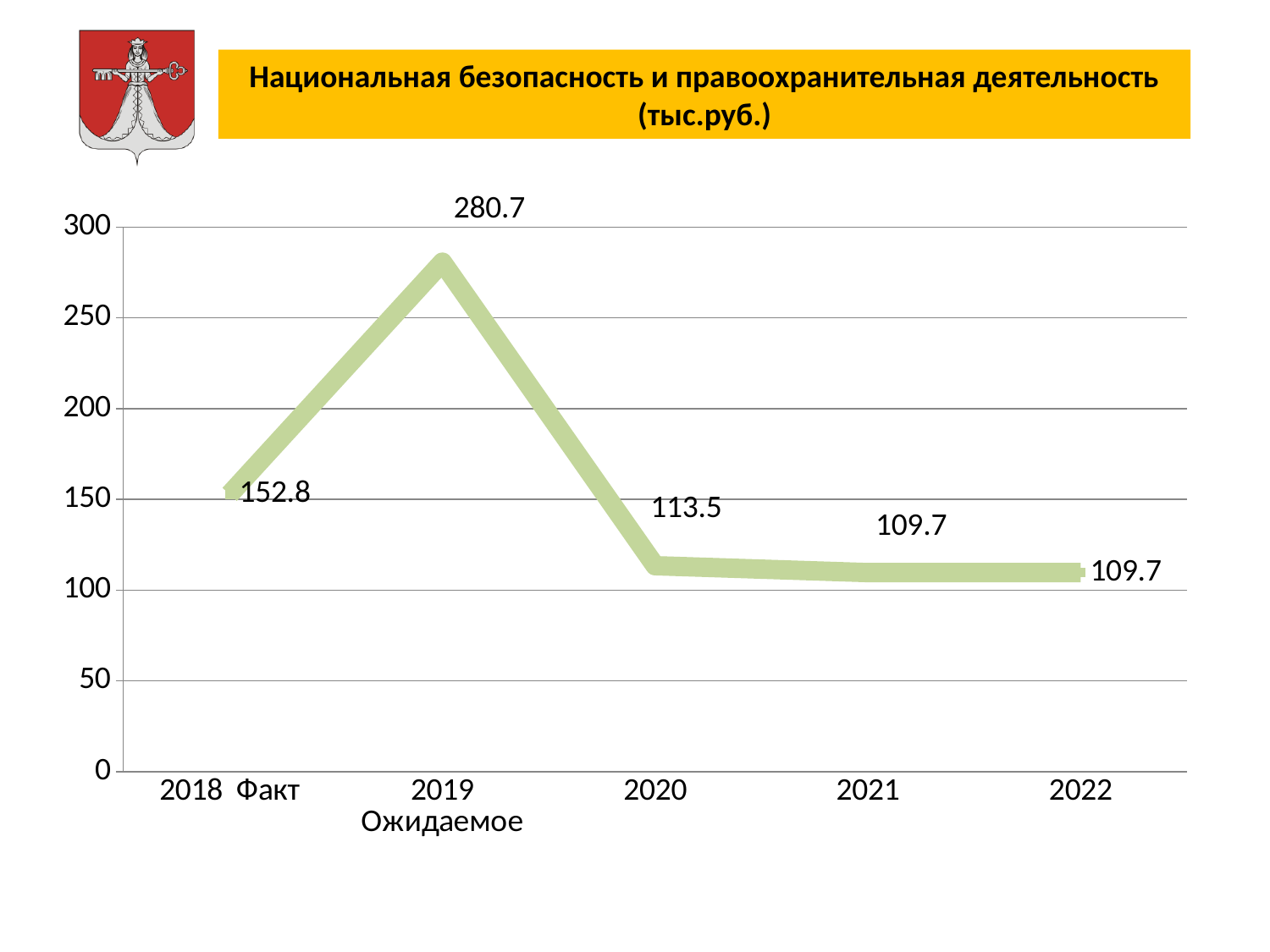
What is the value for 2019 Ожидаемое? 280.7 What is the value for 2020? 113.5 Do the values rise or fall from 2019 Ожидаемое to 2020? fall What is the difference between the values for 2020 and 2021? 3.8 Which year has the highest value? 2019 Ожидаемое Is the value for 2019 Ожидаемое greater or less than 250? greater What is the difference between the values for 2019 Ожидаемое and 2018 Факт? 127.9 What kind of chart is shown on the slide? line chart Which is larger, the value for 2018 Факт or the value for 2020? 2018 Факт What is the value for 2018 Факт? 152.8 How many data points are plotted on the chart? 5 What is the value for 2022? 109.7